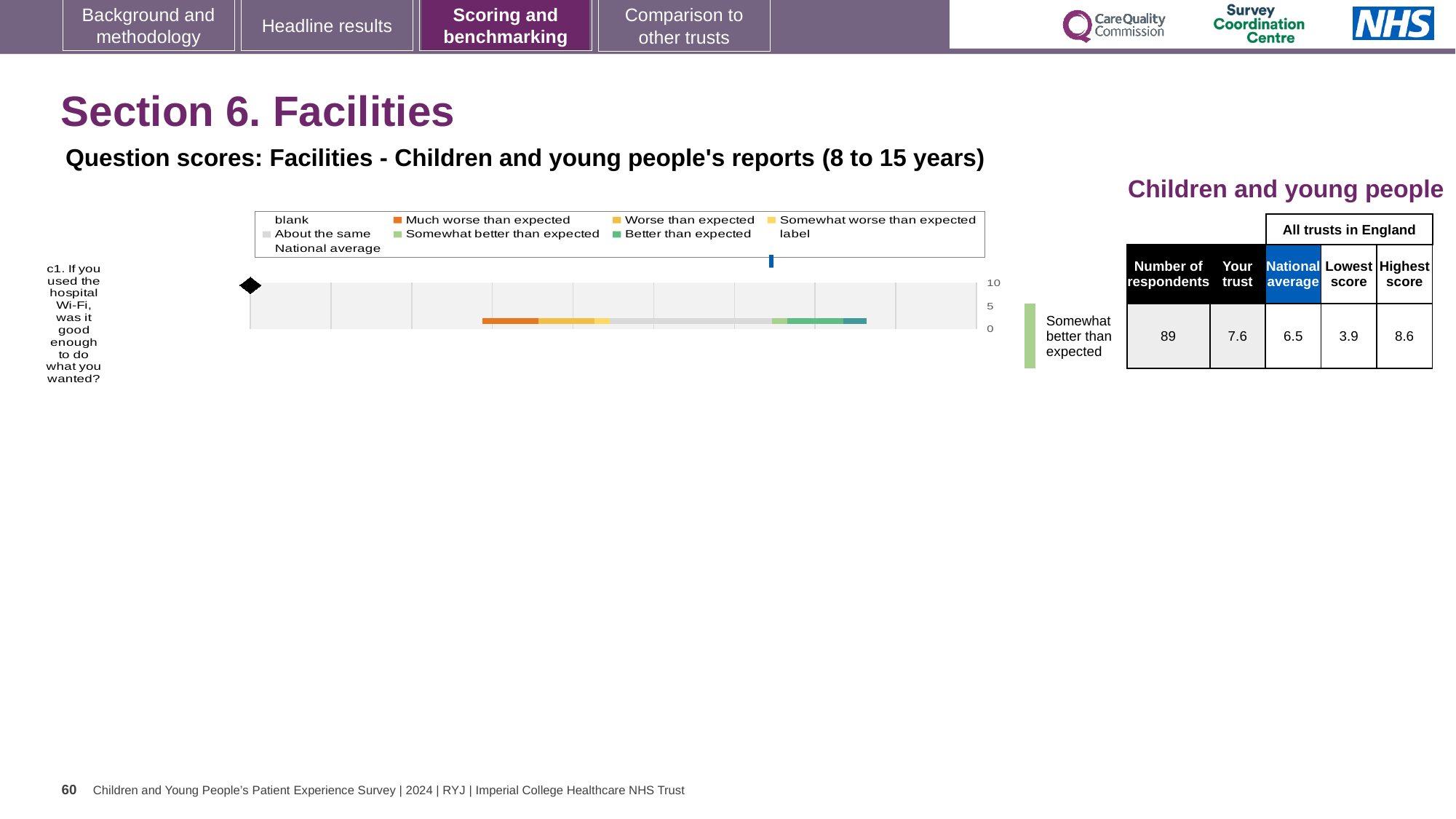
What kind of chart is used to show the question score for c1 on this slide? bar chart Which benchmark category is the trust's result for question c1 placed in? Somewhat better than expected How many survey questions are plotted in the chart on this slide? 1 For question c1, which is higher: the trust's score or the national average? Your trust (7.6) What is the 'Your trust' score for question c1 (hospital Wi-Fi)? 7.6 By how much does the trust's score for question c1 exceed the national average? 1.1 What is the highest score among all trusts in England for question c1? 8.6 What is the difference between the highest and lowest scores for question c1 across all trusts in England? 4.7 Is the trust's score for question c1 greater or less than 5 on the chart's axis? greater What is the national average score for question c1 (hospital Wi-Fi)? 6.5 How many respondents answered question c1 (hospital Wi-Fi)? 89 What is the lowest score among all trusts in England for question c1? 3.9